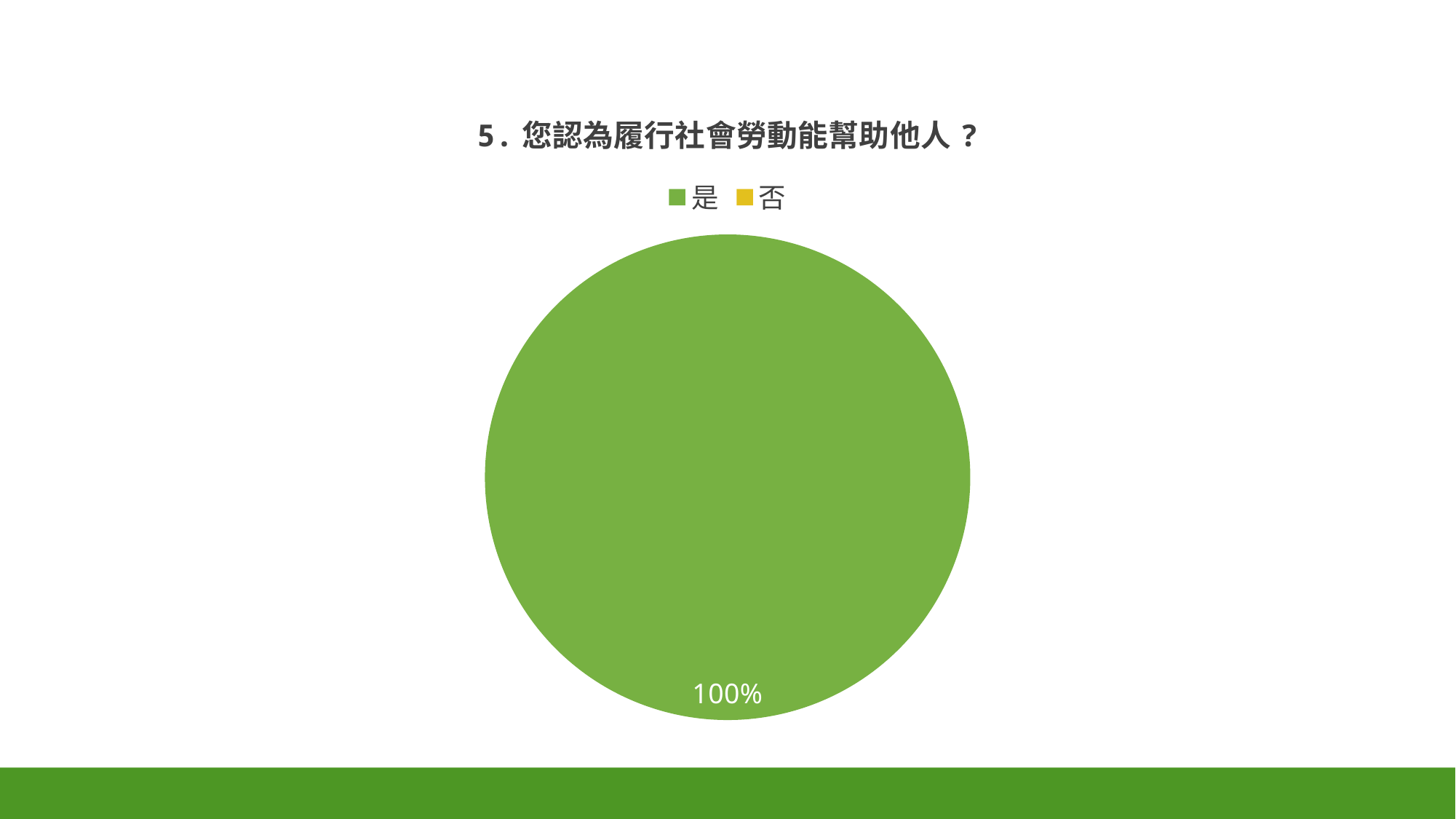
How many entries does the legend list? 2 Which of 是 or 否 has the larger share of the pie? 是 What share of the pie does 是 take? 100% Is the share for 是 greater or less than 50%? greater Which legend entry is shown in green? 是 What kind of chart is shown on the slide? pie chart Which category takes the largest share of the pie? 是 What is the value printed on the pie chart? 100% What is the title of the chart? 5. 您認為履行社會勞動能幫助他人？